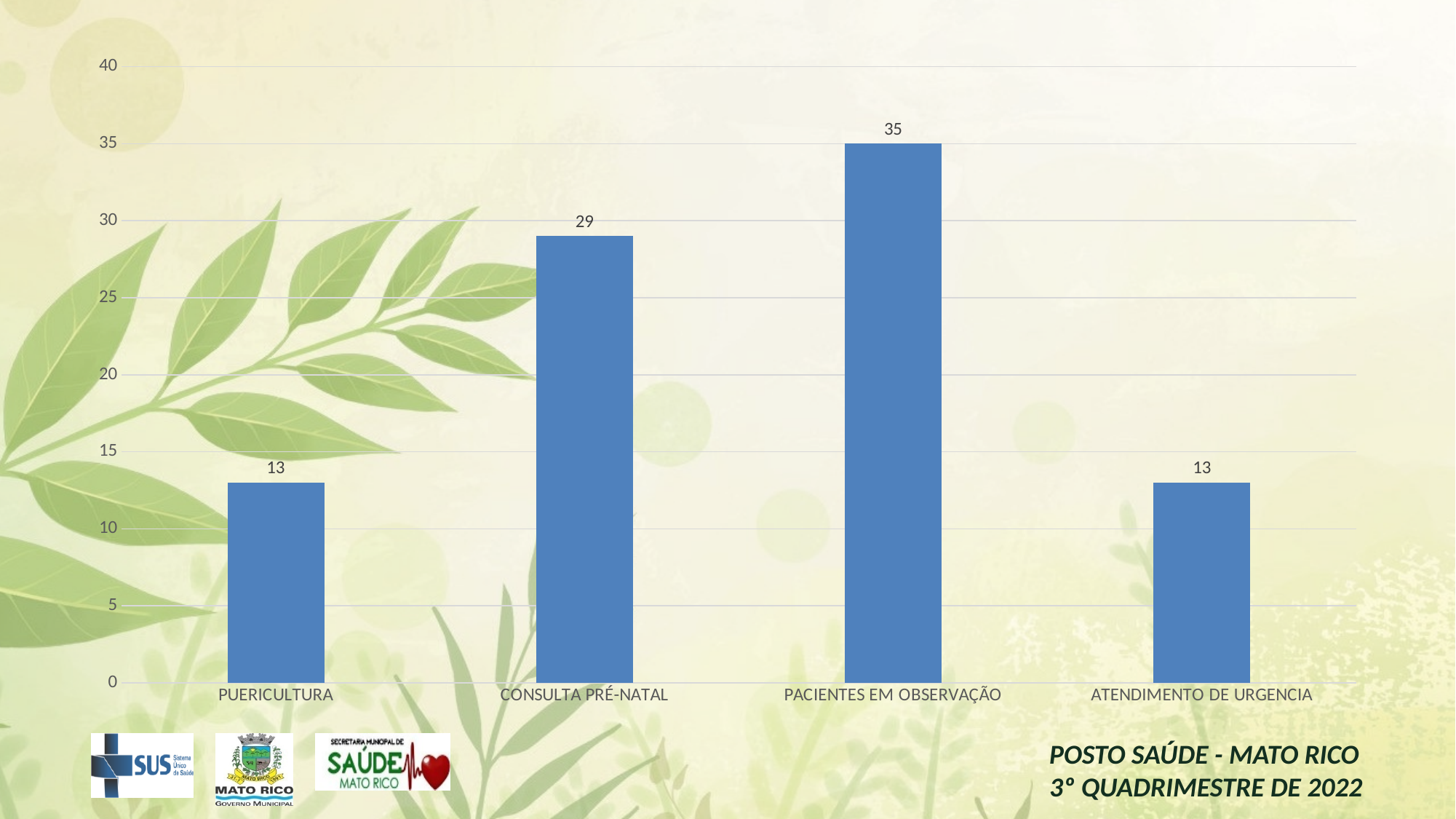
Is the value for PACIENTES EM OBSERVAÇÃO greater or less than 30? greater Which is larger, the value for CONSULTA PRÉ-NATAL or the value for ATENDIMENTO DE URGENCIA? CONSULTA PRÉ-NATAL What kind of chart is shown on the slide? bar chart What is the value for ATENDIMENTO DE URGENCIA? 13 Which category has the highest value? PACIENTES EM OBSERVAÇÃO How many categories are shown on the x axis? 4 What is the value for PUERICULTURA? 13 What is the highest value shown on the vertical axis? 40 What is the difference between the values for PACIENTES EM OBSERVAÇÃO and CONSULTA PRÉ-NATAL? 6 What is the difference between the values for CONSULTA PRÉ-NATAL and PUERICULTURA? 16 What is the value for CONSULTA PRÉ-NATAL? 29 What is the value for PACIENTES EM OBSERVAÇÃO? 35